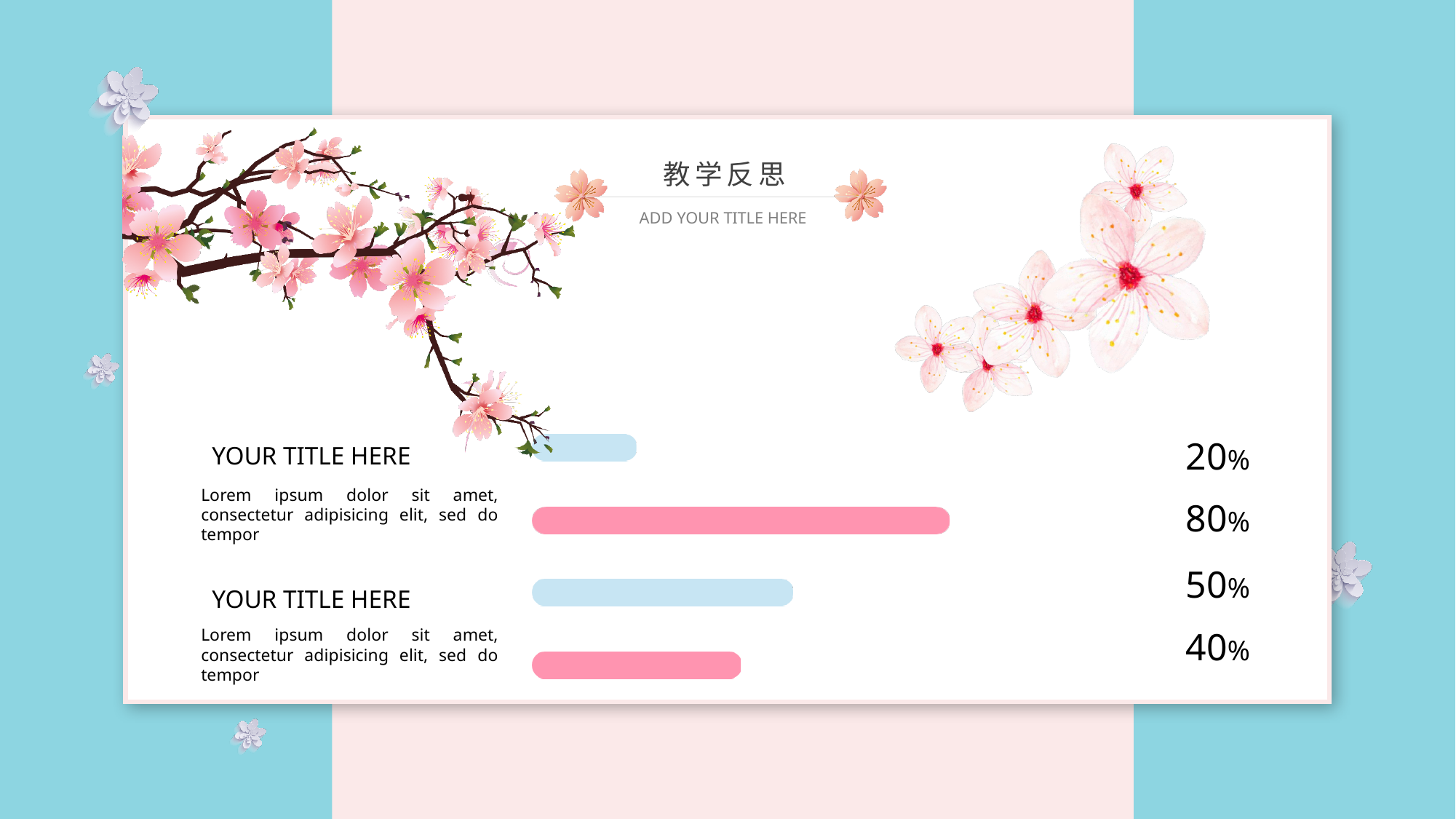
Which bar has the highest value? the second bar from the top (80%) Which is larger, the value of the third bar (50%) or the bottom bar (40%)? the third bar (50%) What is the difference between the highest and lowest bar values? 60% What value is shown for the bottom bar of the chart? 40% What kind of chart is shown on the slide? bar chart Which bar has the lowest value? the top bar (20%) What value is shown for the third bar from the top? 50% What value is shown for the second bar from the top? 80% What value is shown for the top bar of the chart? 20% What colour is the longest bar in the chart? pink How many bars does the chart contain? 4 What is the difference between the second bar (80%) and the bottom bar (40%)? 40%